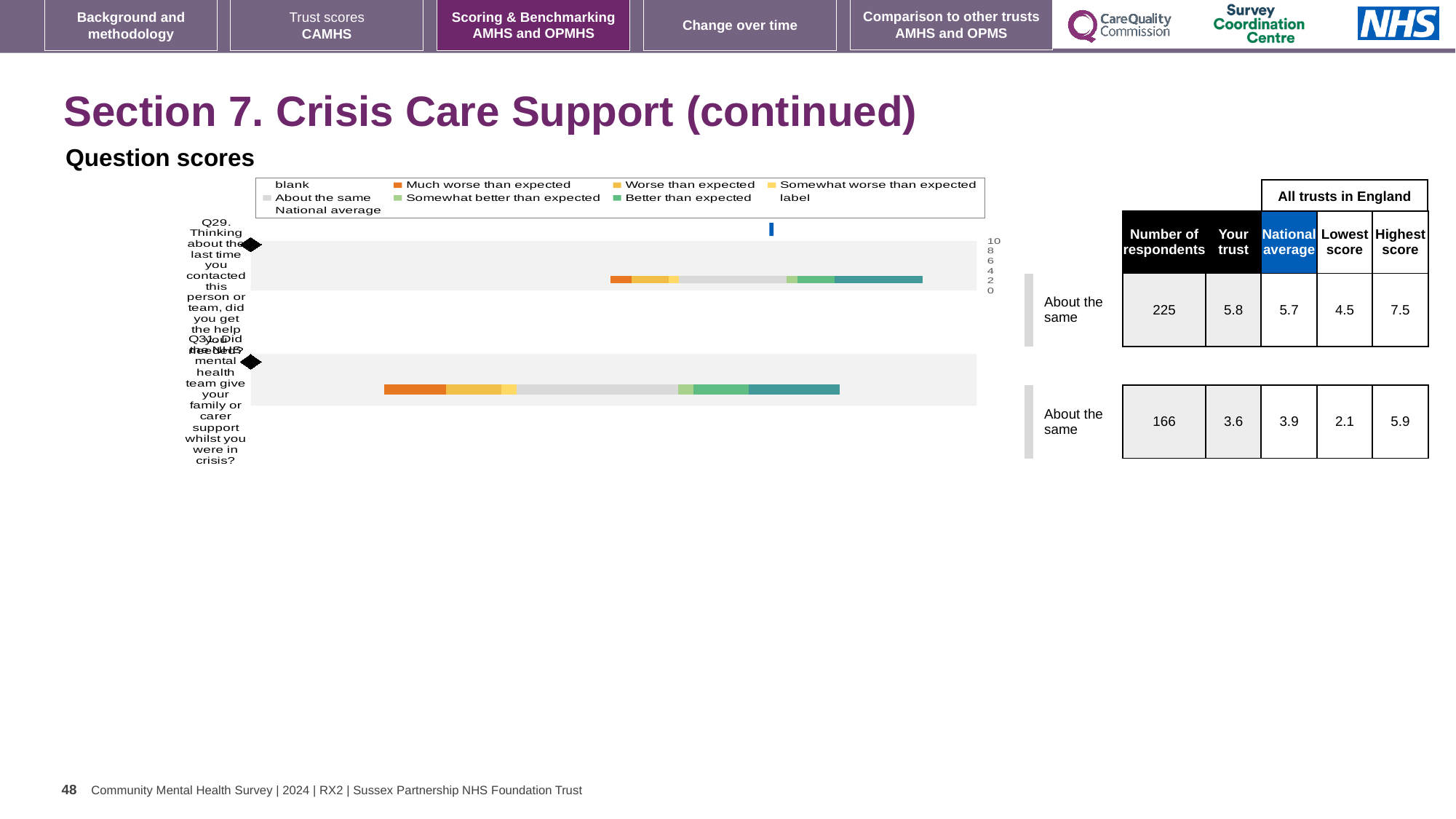
What is the national average score for Q31 (support for family or carer whilst in crisis)? 3.9 What is the 'Your trust' score for Q29 (did you get the help you needed)? 5.8 What kind of chart is shown under 'Question scores'? bar chart What is the lowest score among all trusts in England for Q31? 2.1 What is the difference between the highest score and the lowest score for Q31? 3.8 Which legend entry is shown in orange? Much worse than expected Which question has the higher 'Your trust' score, Q29 or Q31? Q29 For Q29, is the 'Your trust' score higher or lower than the national average? higher How many questions (bars) are plotted in the chart? 2 What benchmark category label is given for both Q29 and Q31? About the same How many respondents answered Q29? 225 What is the difference between the highest score and the lowest score for Q29? 3.0